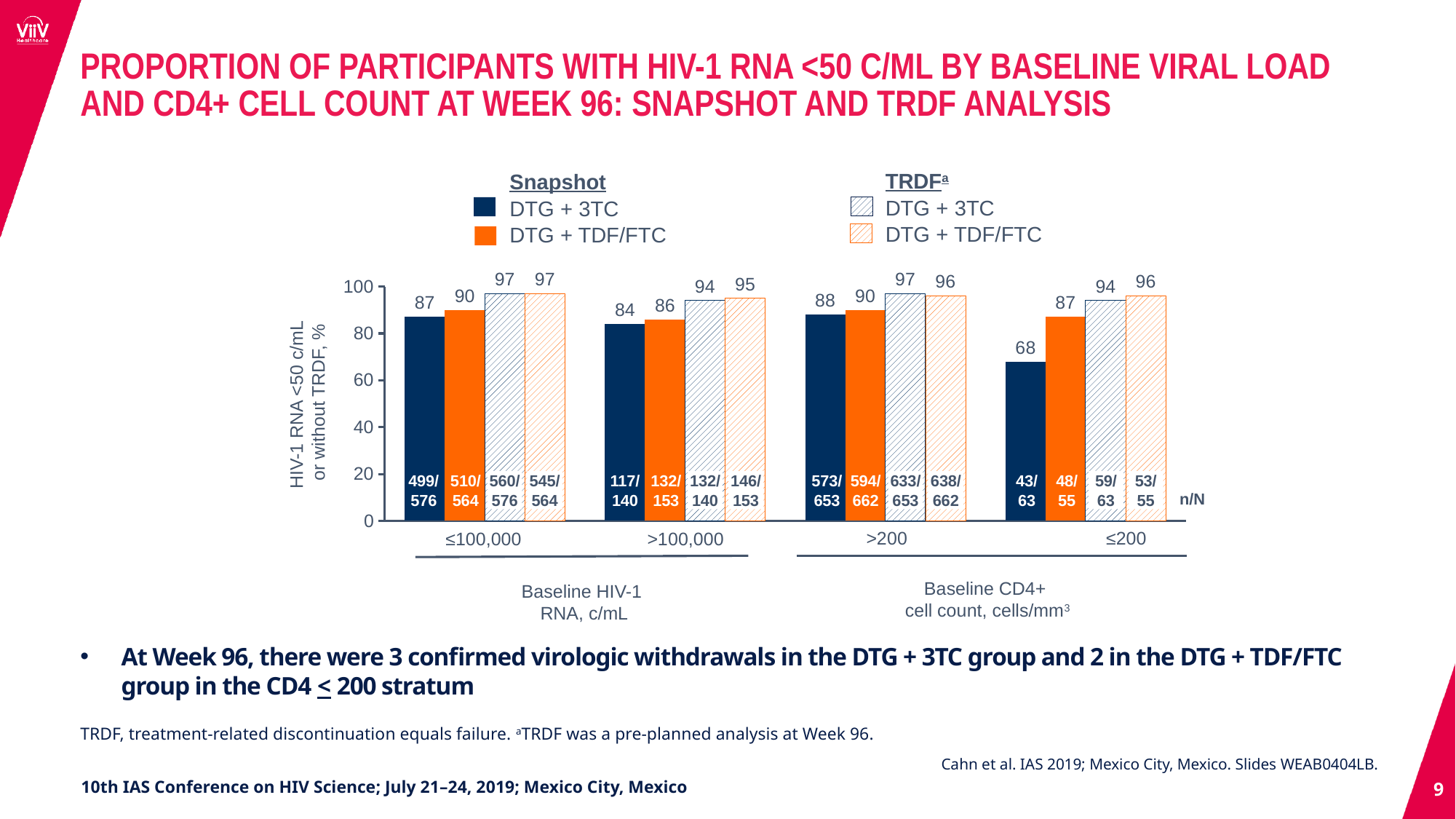
What is the n/N shown for the Snapshot DTG + 3TC bar in the ≤200 CD4+ group? 43/63 What is the Snapshot value for DTG + TDF/FTC in the ≤200 baseline CD4+ cell count group? 87 What is the Snapshot value for DTG + 3TC in the ≤100,000 baseline HIV-1 RNA group? 87 What kind of chart is shown on the slide? bar chart What is the difference between the Snapshot DTG + TDF/FTC and Snapshot DTG + 3TC values in the ≤200 CD4+ group? 19 How many baseline subgroup categories are shown on the x axis? 4 What is the y-axis label of the chart? HIV-1 RNA <50 c/mL or without TRDF, % In the >100,000 baseline HIV-1 RNA group, which is larger: the TRDF value for DTG + 3TC or for DTG + TDF/FTC? DTG + TDF/FTC How many series does the legend list in total? 4 Which bar has the lowest value on the chart? Snapshot DTG + 3TC in the ≤200 CD4+ group Is the Snapshot DTG + 3TC value in the ≤200 CD4+ group greater or less than 80? less What is the TRDF value for DTG + 3TC in the >200 baseline CD4+ cell count group? 97